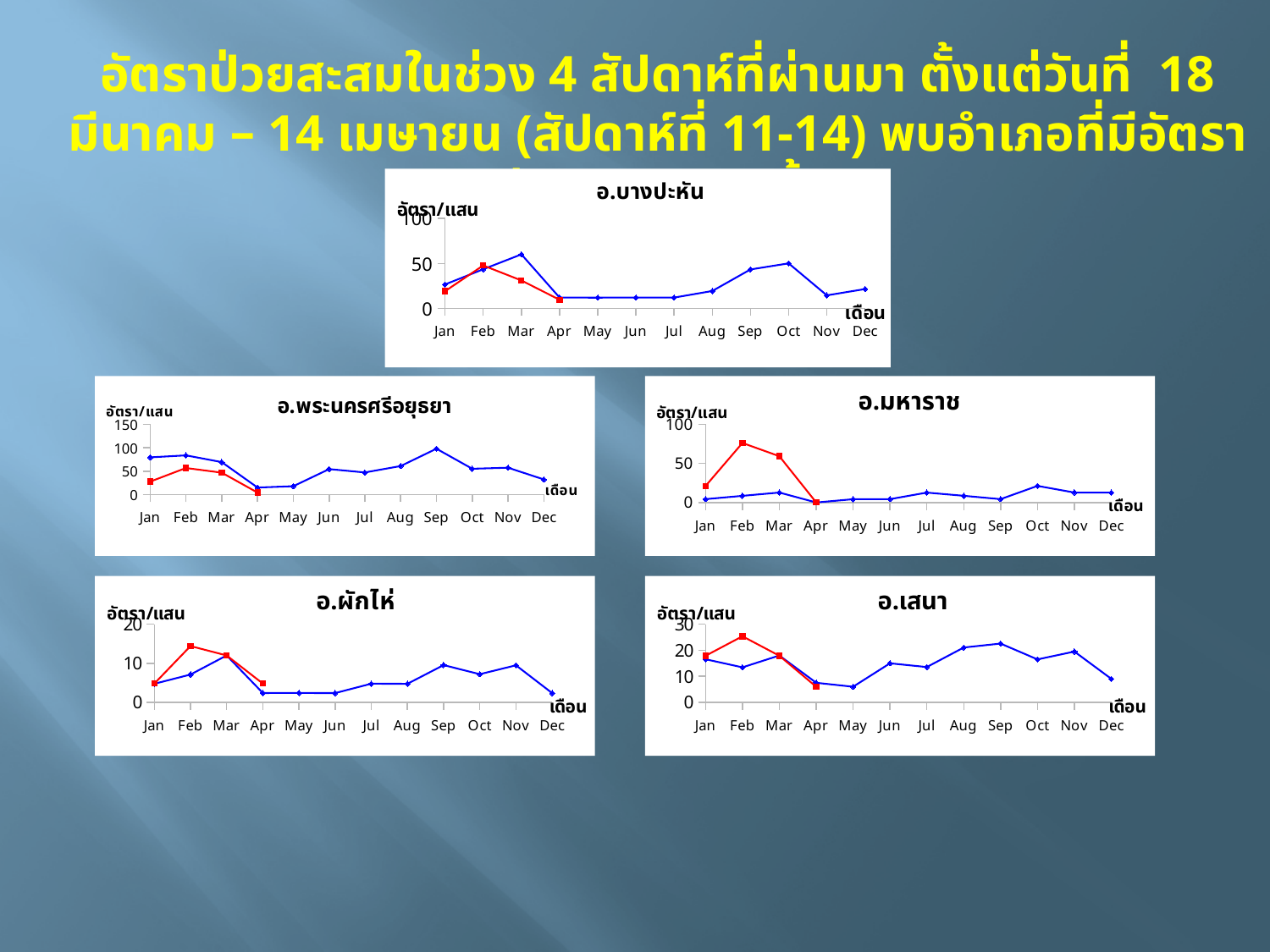
In the อ.มหาราช chart, is the red line's value for Feb greater or less than 50? greater In the อ.พระนครศรีอยุธยา chart, how many months are plotted along the x axis? 12 In the อ.บางปะหัน chart, in which month does the red line reach its highest value? Feb How many charts are shown on the slide? 5 In the อ.มหาราช chart, in which month does the red line reach its highest value? Feb In the อ.ผักไห่ chart, is the red line's value for Feb greater or less than 10? greater In the อ.บางปะหัน chart, is the blue line's value for Mar greater or less than 50? greater What is the y-axis label on the อ.เสนา chart? อัตรา/แสน What kind of chart is the อ.บางปะหัน chart? line chart In the อ.พระนครศรีอยุธยา chart, in which month does the blue line reach its highest value? Sep